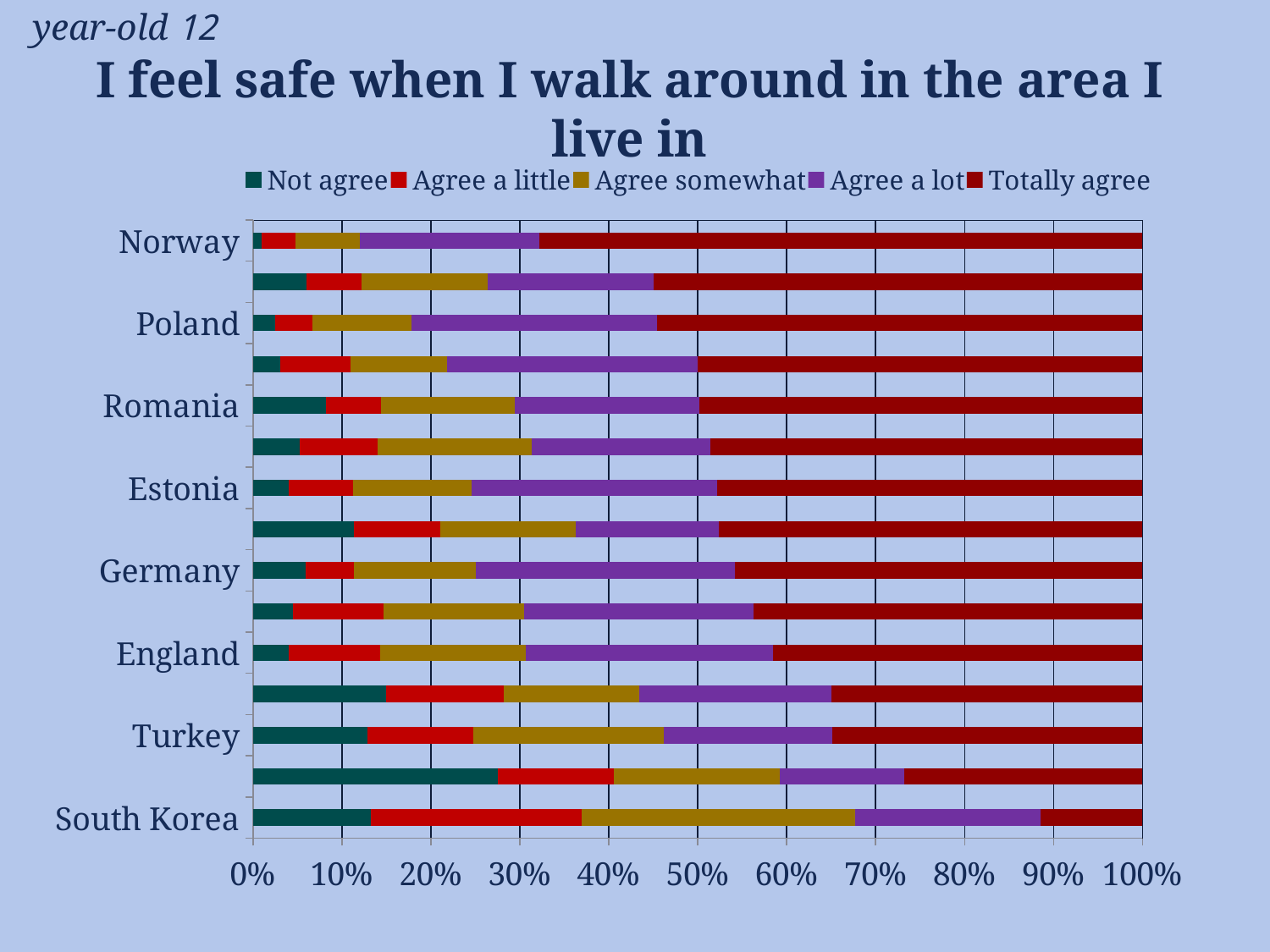
Which legend entry is listed last? Totally agree Among the labelled countries, which has the largest 'Totally agree' share? Norway Is the 'Not agree' share for Norway greater or less than 10%? less What kind of chart is shown on the slide? Stacked bar chart Is the 'Not agree' share for South Korea greater or less than 10%? greater Among the labelled countries, which has the smallest 'Totally agree' share? South Korea How many series does the legend list? 5 Which has the larger 'Totally agree' share, Norway or South Korea? Norway Is the 'Totally agree' share for Norway greater or less than 60%? greater What is the title of the chart? I feel safe when I walk around in the area I live in Moving down the chart from Norway to South Korea, does the 'Totally agree' share generally increase or decrease? decrease